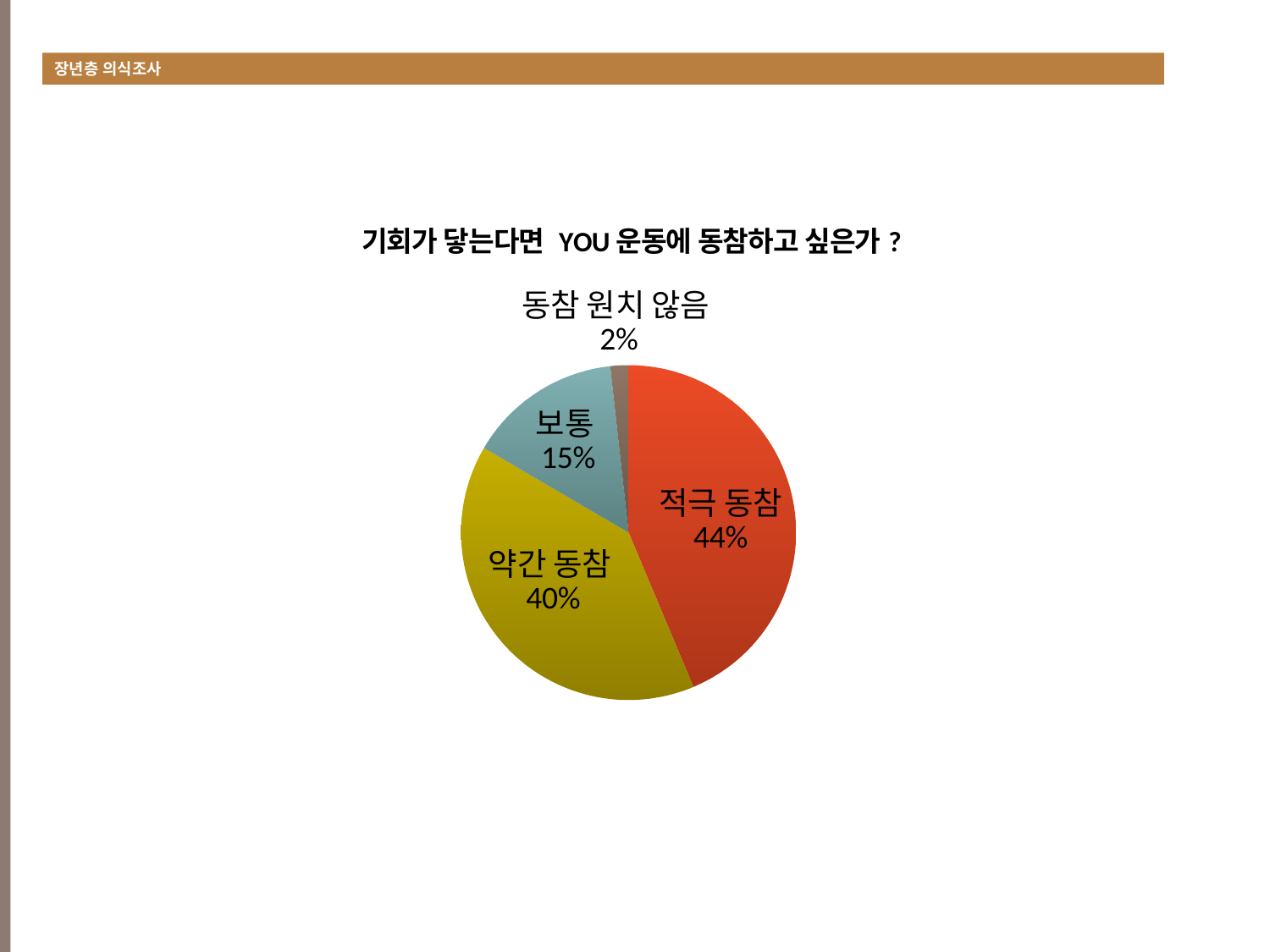
What is the value shown for 보통? 15% How many slices does the pie chart have? 4 What kind of chart is shown on the slide? pie chart What share of the pie does 적극 동참 represent? 44% What is the difference between the shares of 적극 동참 and 약간 동참? 4% Which is larger, the share for 보통 or the share for 약간 동참? 약간 동참 What is the difference between the shares of 보통 and 동참 원치 않음? 13% What is the value shown for 동참 원치 않음? 2% What is the title of the chart? 기회가 닿는다면 YOU 운동에 동참하고 싶은가 ? Which slice of the pie is the largest? 적극 동참 Which slice of the pie is the smallest? 동참 원치 않음 What share of the pie does 약간 동참 represent? 40%